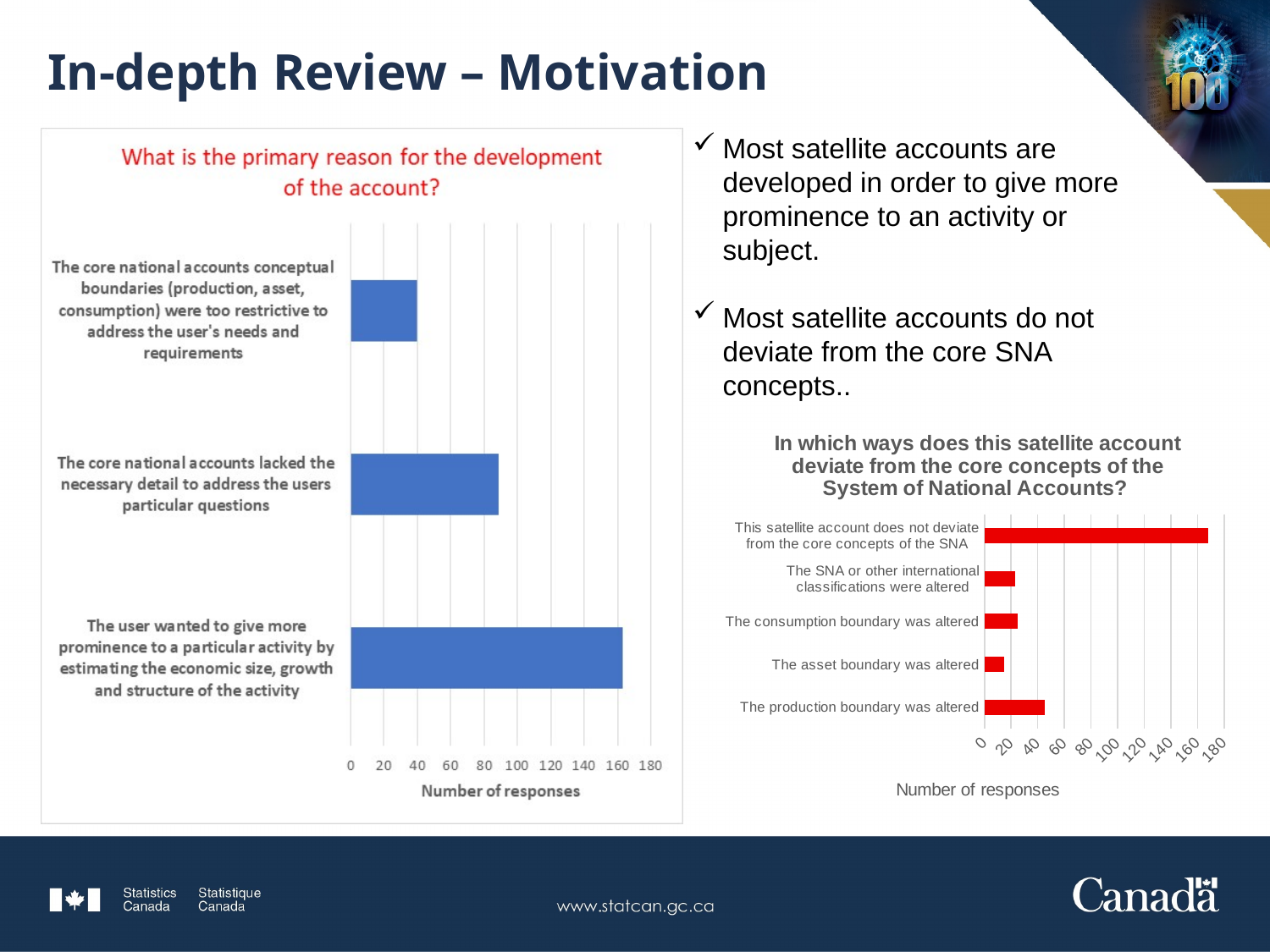
On the chart titled "In which ways does this satellite account deviate from the core concepts of the System of National Accounts?", which category has the lowest number of responses? The asset boundary was altered On the chart titled "In which ways does this satellite account deviate from the core concepts of the System of National Accounts?", which has more responses: "The production boundary was altered" or "The asset boundary was altered"? The production boundary was altered On the chart titled "In which ways does this satellite account deviate from the core concepts of the System of National Accounts?", is the value for "The production boundary was altered" greater or less than 20? greater On the chart titled "In which ways does this satellite account deviate from the core concepts of the System of National Accounts?", how many categories are plotted? 5 On the chart titled "What is the primary reason for the development of the account?", which category has the highest number of responses? The user wanted to give more prominence to a particular activity by estimating the economic size, growth and structure of the activity On the chart titled "What is the primary reason for the development of the account?", how many categories are plotted? 3 On the chart titled "What is the primary reason for the development of the account?", is the value for "The core national accounts lacked the necessary detail to address the users particular questions" greater or less than 60? greater On the chart titled "In which ways does this satellite account deviate from the core concepts of the System of National Accounts?", which category has the highest number of responses? This satellite account does not deviate from the core concepts of the SNA On the chart titled "In which ways does this satellite account deviate from the core concepts of the System of National Accounts?", what colour are the bars? Red On the chart titled "What is the primary reason for the development of the account?", which category has the lowest number of responses? The core national accounts conceptual boundaries (production, asset, consumption) were too restrictive to address the user's needs and requirements On the chart titled "What is the primary reason for the development of the account?", what kind of chart is shown? Bar chart On the chart titled "What is the primary reason for the development of the account?", what is the label of the horizontal axis? Number of responses